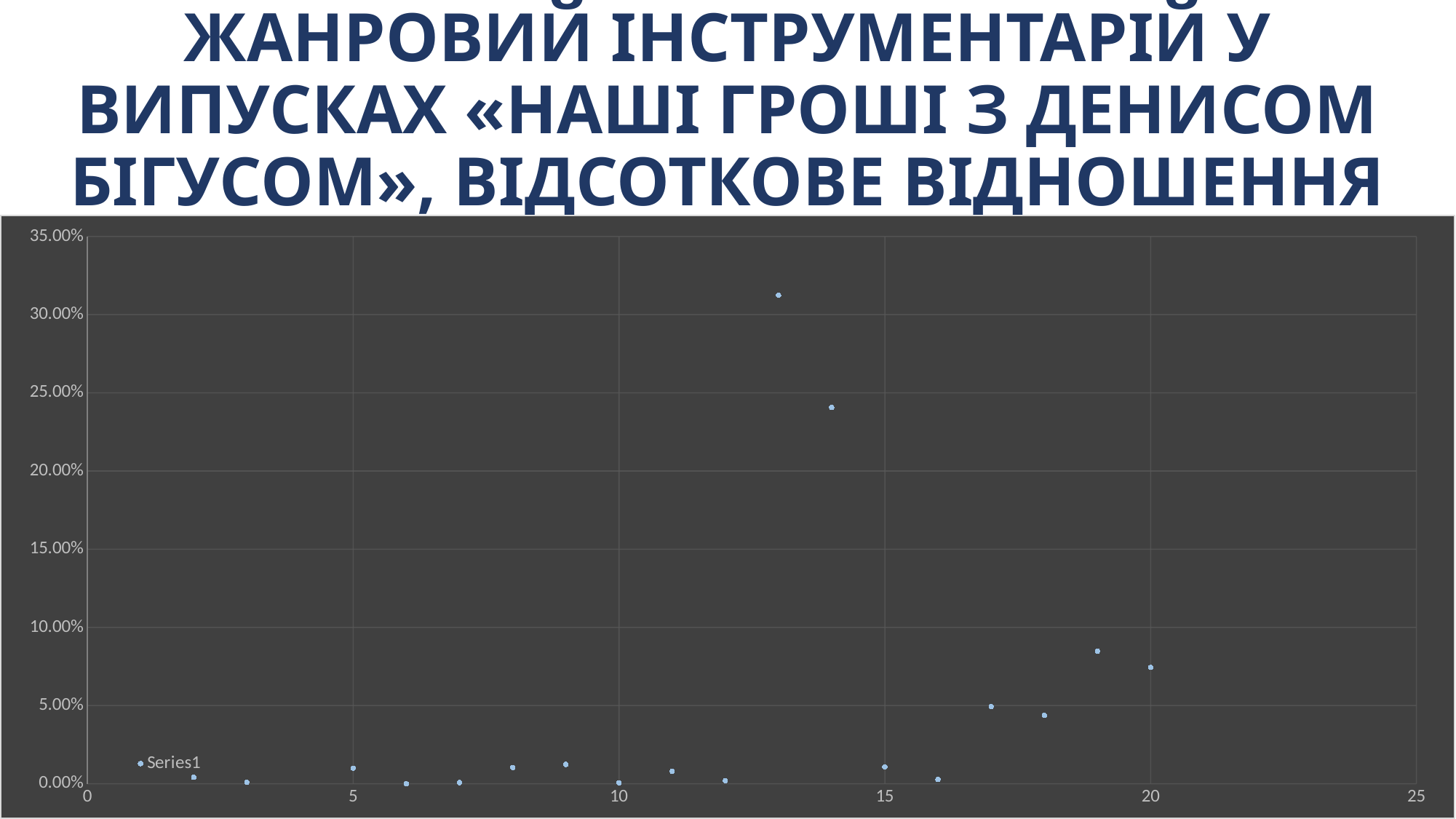
What is the highest value shown on the vertical axis of the chart? 35.00% Is the value of the point at x = 14 greater or less than 25.00%? less Is the value of the point at x = 20 greater or less than 10.00%? less Is the value of the point at x = 19 greater or less than 5.00%? greater What is the name of the data series shown on the chart? Series1 Which point has the larger value, the one at x = 19 or the one at x = 20? x = 19 At which x value does the highest point on the chart occur? 13 What kind of chart is shown on the slide? scatter chart Which point has the larger value, the one at x = 13 or the one at x = 14? x = 13 How many data series are plotted on the chart? 1